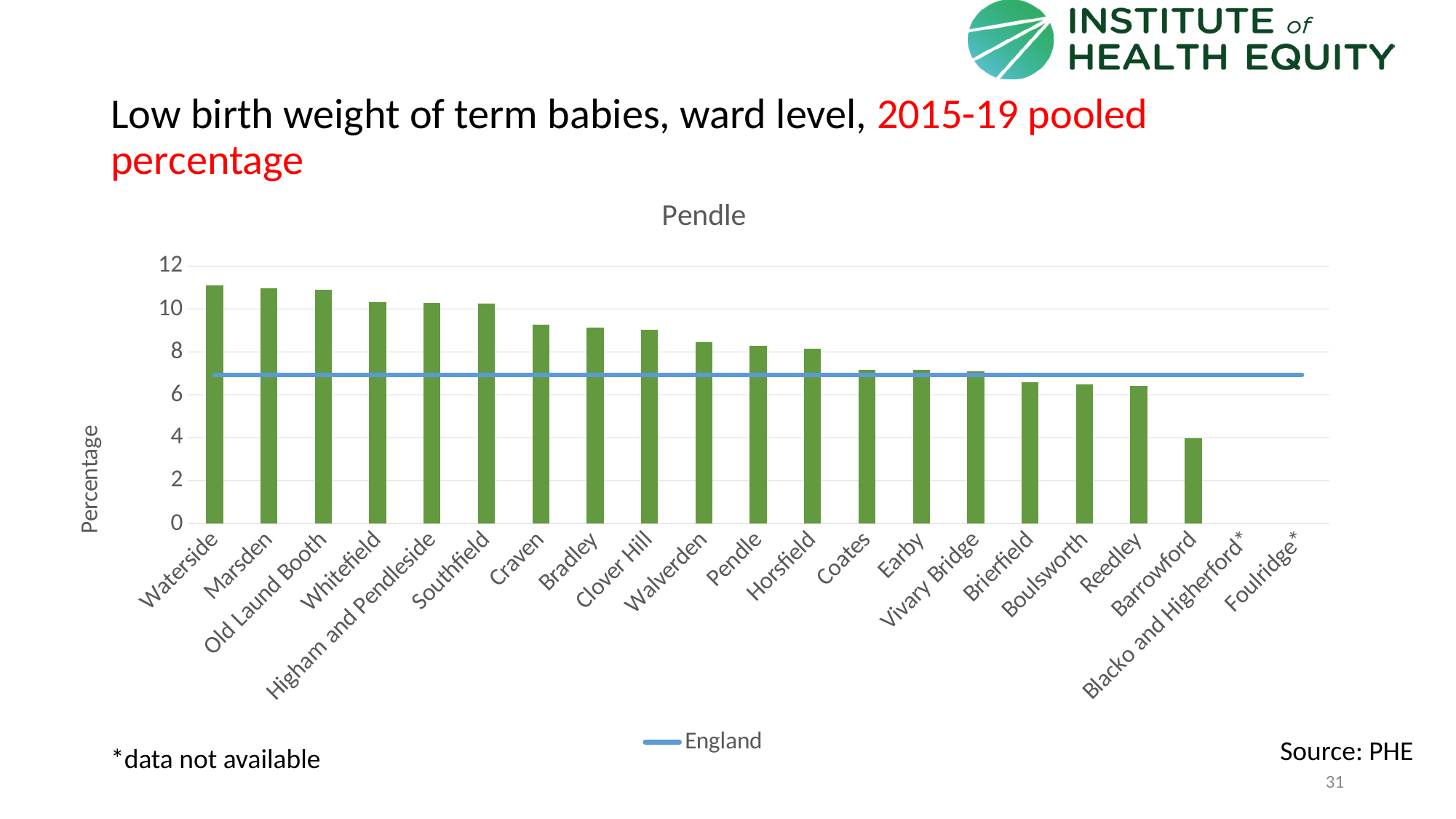
Do the bar values rise or fall from left to right across the chart? Fall Which ward has the lowest bar on the chart? Barrowford Which has the larger value, Craven or Reedley? Craven Is the value for Waterside greater or less than 10? greater What entry does the legend list? England What is the title of the chart? Pendle What is the label on the vertical axis? Percentage What kind of chart is shown on the slide? Bar chart Is the value for Barrowford greater or less than 6? less Is the value for Craven greater or less than 8? greater How many ward categories are listed along the x axis? 21